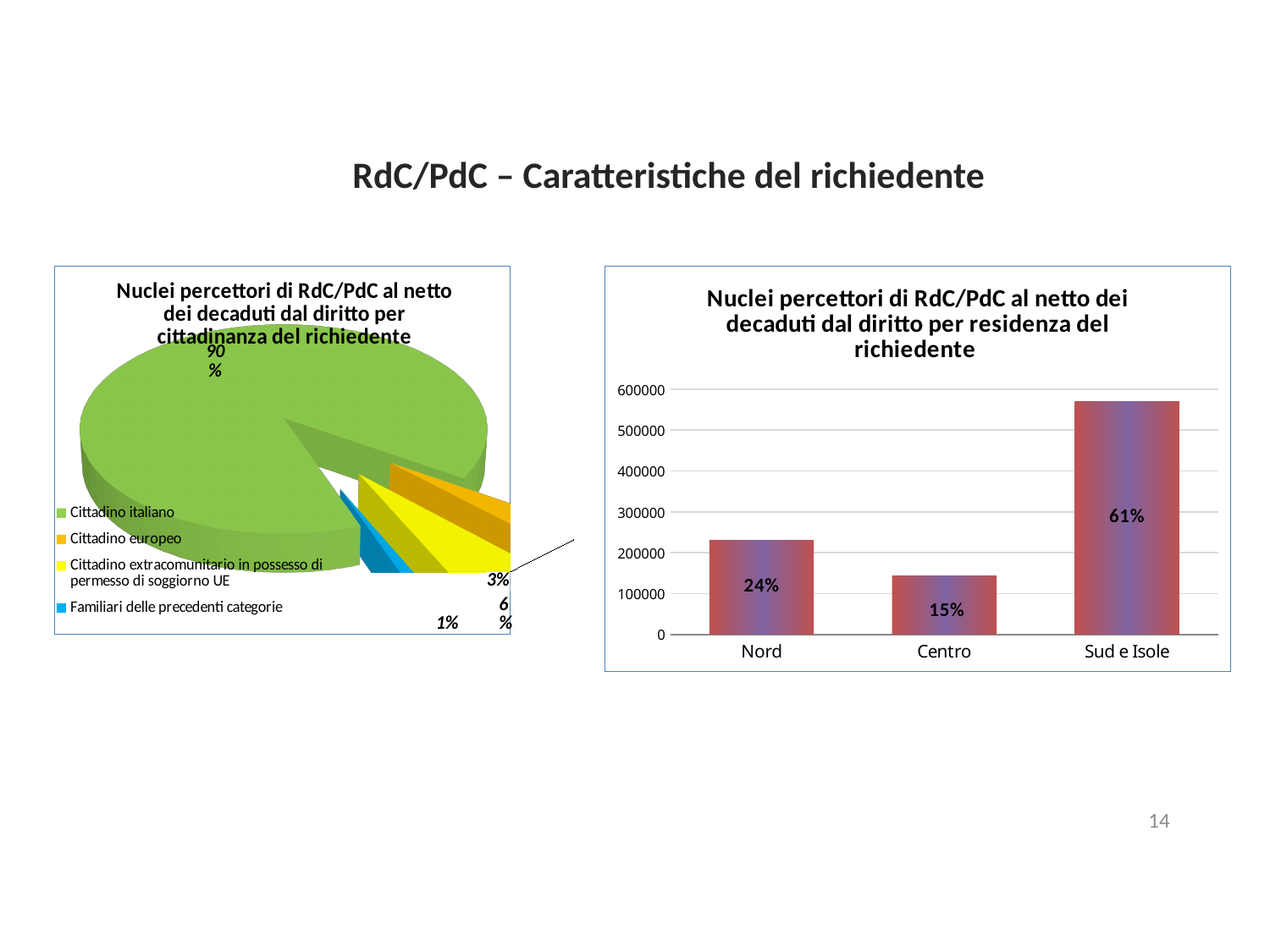
In the bar chart on the right, which region has the lowest value? Centro In the bar chart on the right, what percentage is shown for Sud e Isole? 61% In the bar chart on the right, what is the difference between the percentages for Sud e Isole and Nord? 37% In the bar chart on the right, how many regions are shown on the x axis? 3 In the bar chart on the right, what percentage is shown for Centro? 15% In the bar chart on the right, which is larger, the value for Nord or the value for Centro? Nord In the pie chart on the left, what share of the pie does Cittadino italiano have? 90% What kind of chart is the chart on the right of the slide? bar chart In the bar chart on the right, is the value for Sud e Isole greater or less than 500000? greater In the bar chart on the right, which region has the highest value? Sud e Isole In the pie chart on the left, how many categories does the legend list? 4 In the bar chart on the right, what percentage is shown for Nord? 24%